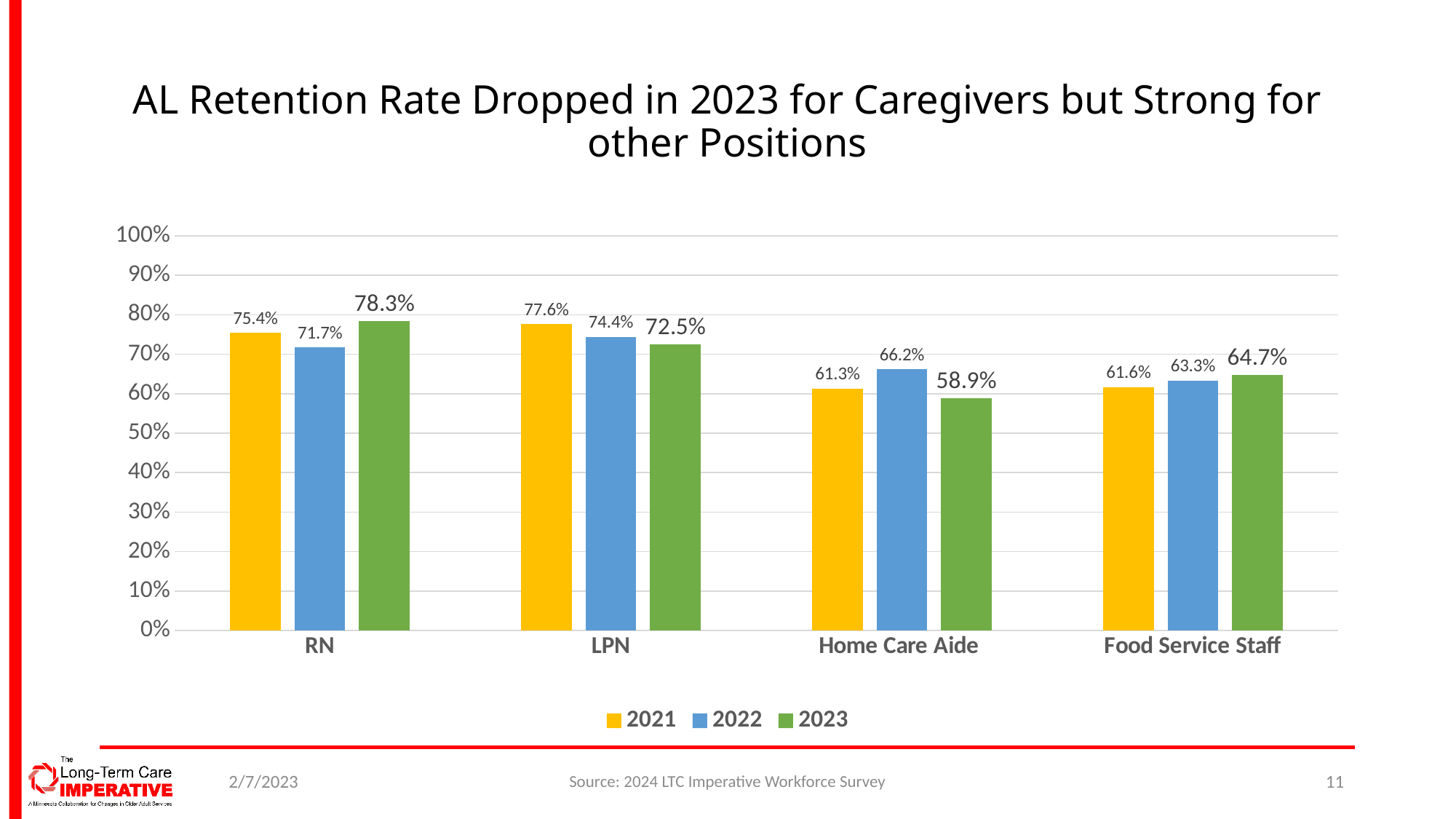
Which colour represents the 2022 series in the legend? blue What is the 2022 retention rate for Home Care Aide? 66.2% Which position has the highest 2021 retention rate? LPN Is the 2023 retention rate for RN higher or lower than the 2023 retention rate for LPN? higher What is the 2023 retention rate for RN? 78.3% What is the 2023 retention rate for Food Service Staff? 64.7% What is the 2021 retention rate for LPN? 77.6% How many positions are shown on the x axis? 4 How many series does the legend list? 3 What kind of chart is shown on the slide? bar chart Which position has the lowest 2023 retention rate? Home Care Aide What is the difference between the 2022 and 2023 retention rates for Home Care Aide? 7.3%